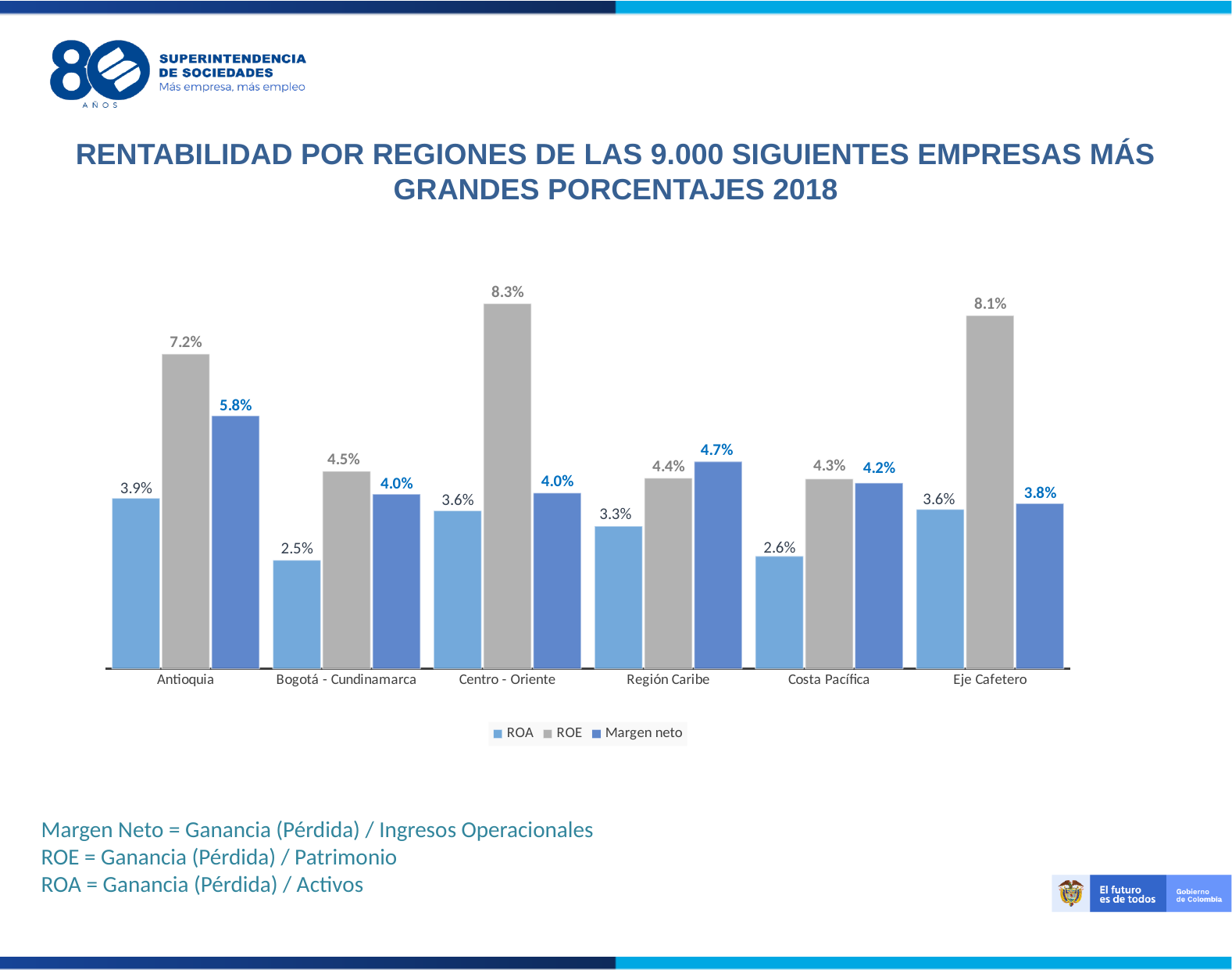
What kind of chart is shown on the slide? Bar chart What is the ROA value for Bogotá - Cundinamarca? 2.5% Which series is shown in grey in the legend? ROE Which region has the highest Margen neto? Antioquia How many series does the legend list? 3 Which region has the highest ROE? Centro - Oriente How many regions are shown on the x axis? 6 Which region has the lowest ROA? Bogotá - Cundinamarca What is the Margen neto value for Antioquia? 5.8% Which is larger for Región Caribe: ROE or Margen neto? Margen neto What is the ROE value for Centro - Oriente? 8.3% What is the difference between the ROE of Eje Cafetero and the ROE of Costa Pacífica? 3.8%